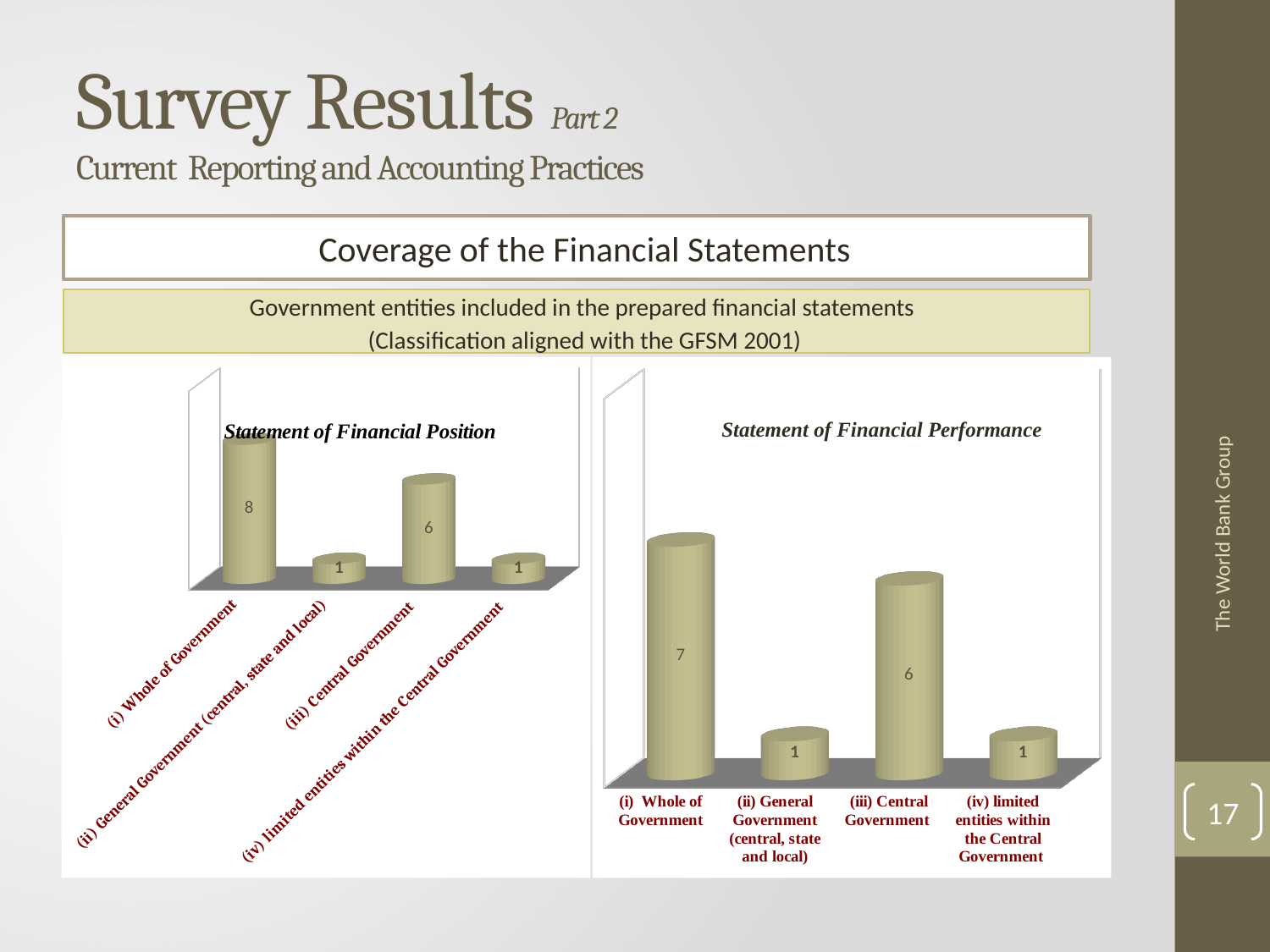
How many categories are shown in the Statement of Financial Position chart? 4 In the Statement of Financial Performance chart, which is larger: the value for (iii) Central Government or (iv) limited entities within the Central Government? (iii) Central Government In the Statement of Financial Performance chart, what is the value for (i) Whole of Government? 7 In the Statement of Financial Position chart, what is the value for (ii) General Government (central, state and local)? 1 In the Statement of Financial Performance chart, what is the value for (iii) Central Government? 6 In the Statement of Financial Position chart, which category has the highest value? (i) Whole of Government What is the title of the chart on the right side of the slide? Statement of Financial Performance In the Statement of Financial Performance chart, what is the difference between the values for (i) Whole of Government and (ii) General Government (central, state and local)? 6 In the Statement of Financial Position chart, what is the value for (i) Whole of Government? 8 What kind of chart is the Statement of Financial Performance chart? Bar chart In the Statement of Financial Performance chart, which category has the highest value? (i) Whole of Government In the Statement of Financial Position chart, what is the difference between the values for (i) Whole of Government and (iii) Central Government? 2